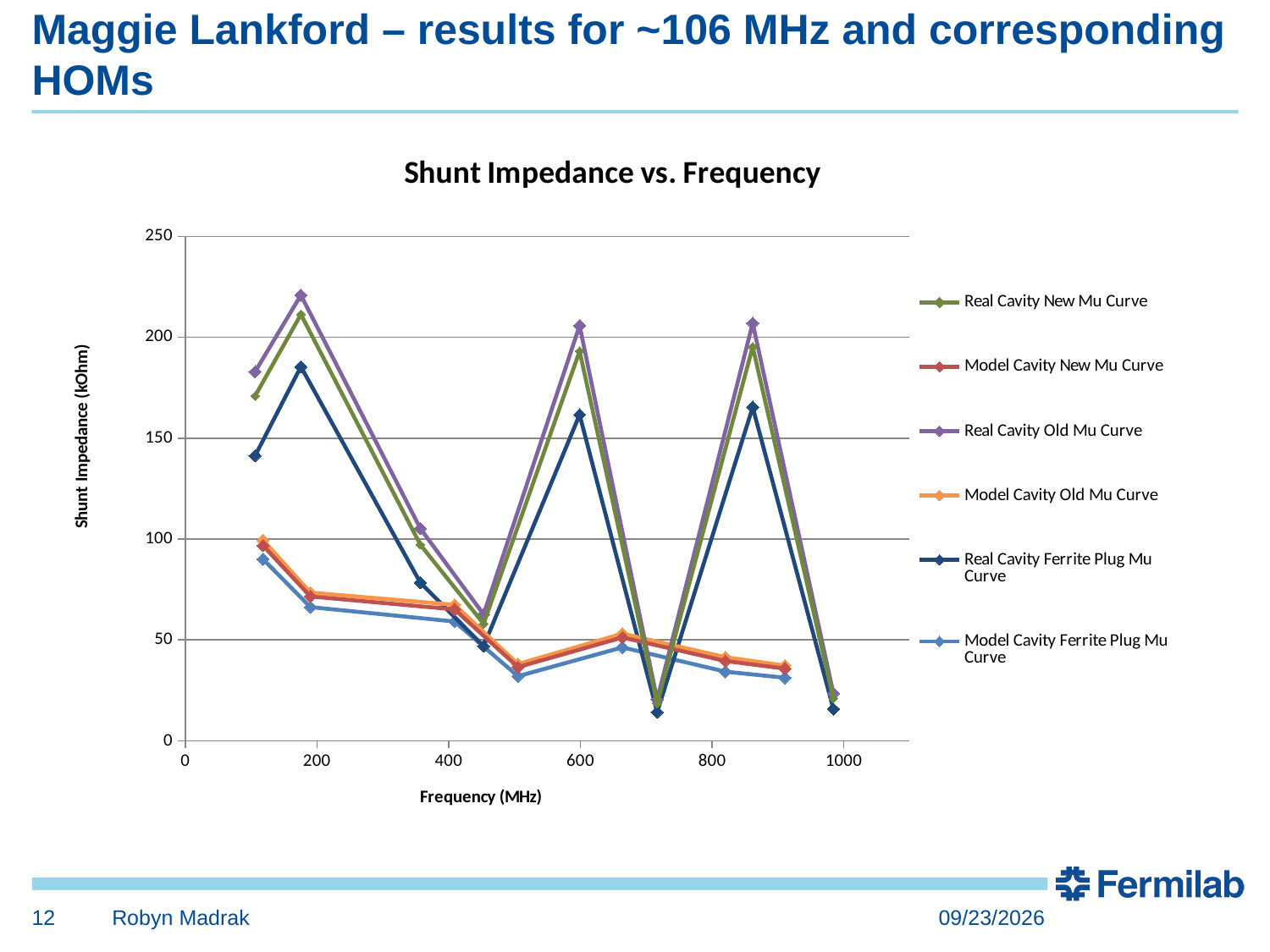
Does the Model Cavity Ferrite Plug Mu Curve rise or fall between about 110 MHz and about 510 MHz? Fall Is the first value of the Real Cavity New Mu Curve, near 110 MHz, greater or less than 150? greater Which series reaches the highest shunt impedance anywhere on the chart? Real Cavity Old Mu Curve Is the peak value of the Real Cavity Old Mu Curve near 180 MHz greater or less than 200? greater At the peak near 600 MHz, which is larger: the Real Cavity Old Mu Curve or the Real Cavity Ferrite Plug Mu Curve? Real Cavity Old Mu Curve What is the title of the chart? Shunt Impedance vs. Frequency What is the label of the vertical axis of the chart? Shunt Impedance (kOhm) What kind of chart is shown on the slide? Line chart How many series does the legend of the chart list? 6 Near 110 MHz, which is larger: the Real Cavity Ferrite Plug Mu Curve or the Model Cavity Ferrite Plug Mu Curve? Real Cavity Ferrite Plug Mu Curve Is the value of the Real Cavity Ferrite Plug Mu Curve at its peak near 600 MHz greater or less than 150? greater